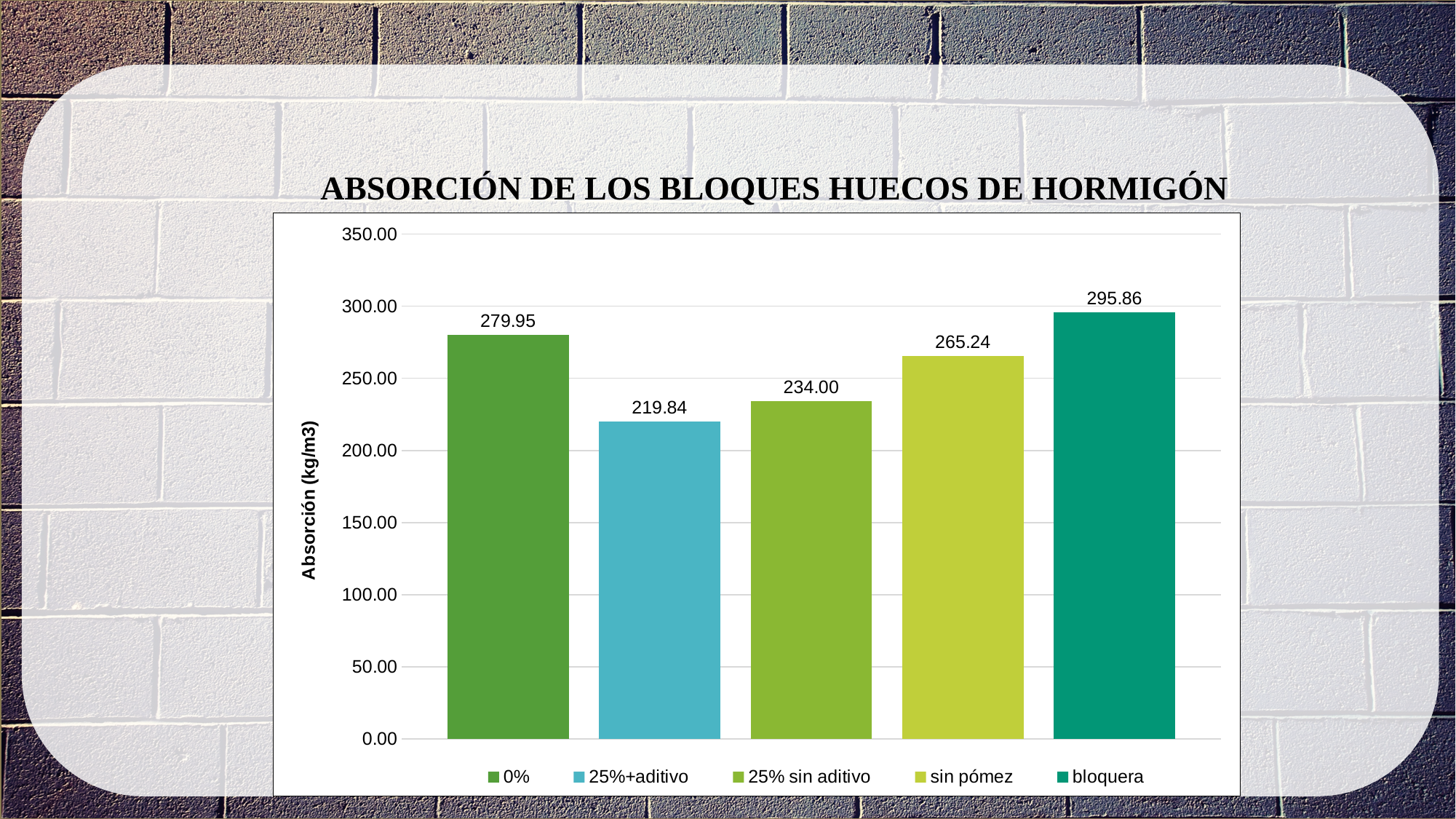
What is the label of the vertical axis? Absorción (kg/m3) Which category has the highest absorption? bloquera What is the absorption value for sin pómez? 265.24 What is the absorption value for the 0% bar? 279.95 Which is larger, the value for sin pómez or the value for 25% sin aditivo? sin pómez What is the absorption value for 25%+aditivo? 219.84 How many bars are shown in the chart? 5 What is the difference between the bloquera value and the 25%+aditivo value? 76.02 What is the difference between the 0% value and the 25% sin aditivo value? 45.95 What type of chart is shown on the slide? bar chart Is the value for 25% sin aditivo greater or less than 250.00? less Which category has the lowest absorption? 25%+aditivo